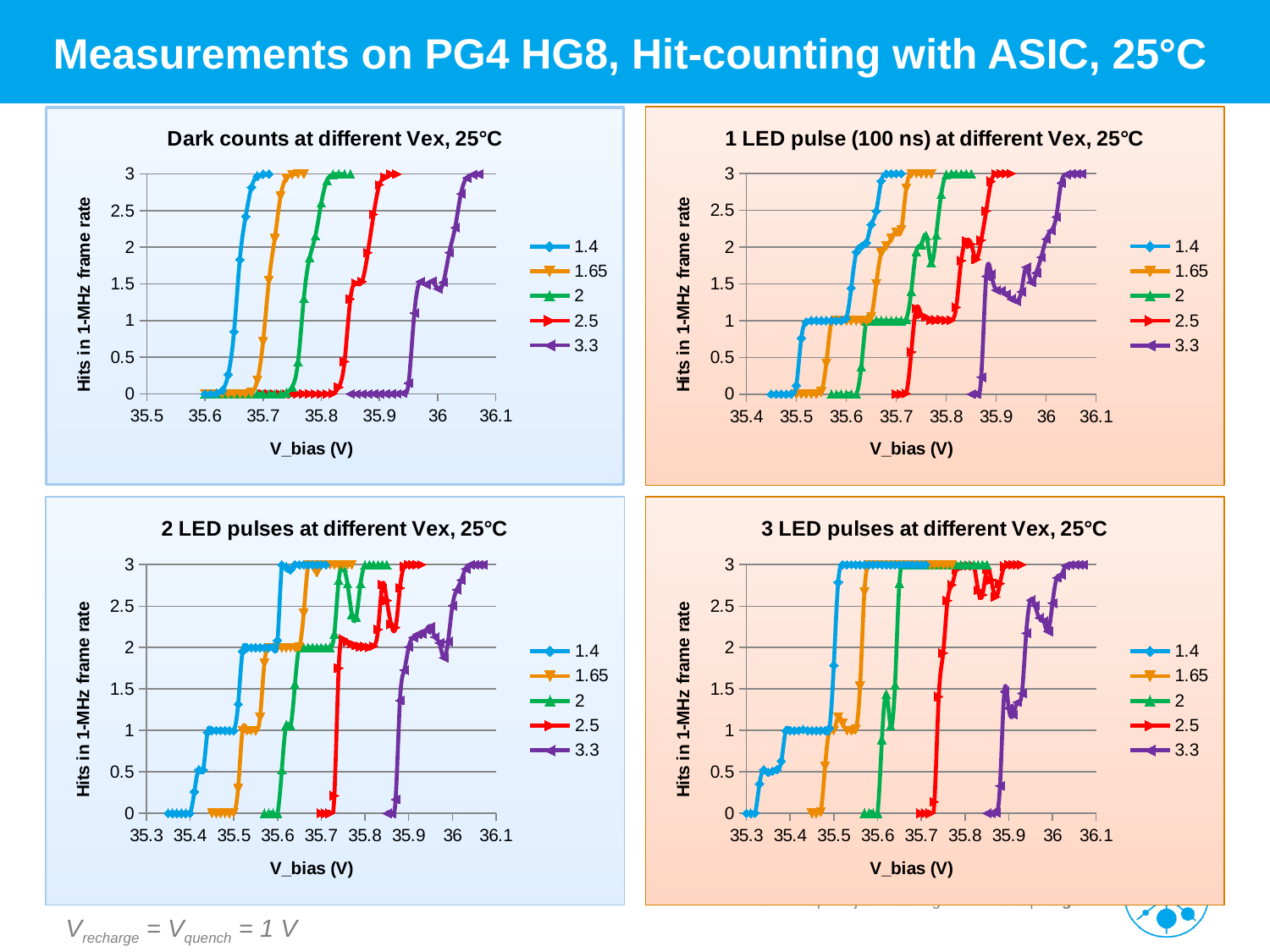
In the '1 LED pulse (100 ns) at different Vex, 25°C' chart, is the value of the 1.4 series at V_bias 35.55 greater or less than 0.5? greater In the '1 LED pulse (100 ns) at different Vex, 25°C' chart, what is the x-axis title? V_bias (V) In the 'Dark counts at different Vex, 25°C' chart, do the values of the 1.4 series rise or fall as V_bias increases? rise In the 'Dark counts at different Vex, 25°C' chart, is the value of the 3.3 series at V_bias 35.9 greater or less than 1? less In the 'Dark counts at different Vex, 25°C' chart, which series reaches the plateau of 3 at a lower V_bias, 1.4 or 3.3? 1.4 What kind of chart is the 'Dark counts at different Vex, 25°C' chart? line chart In the 'Dark counts at different Vex, 25°C' chart, is the value of the 1.4 series at V_bias 35.7 greater or less than 2? greater In the 'Dark counts at different Vex, 25°C' chart, what is the y-axis title? Hits in 1-MHz frame rate How many series does the legend of the '3 LED pulses at different Vex, 25°C' chart list? 5 In the '2 LED pulses at different Vex, 25°C' chart, which series reaches the plateau of 3 at a lower V_bias, 2 or 2.5? 2 How many series does the legend of the 'Dark counts at different Vex, 25°C' chart list? 5